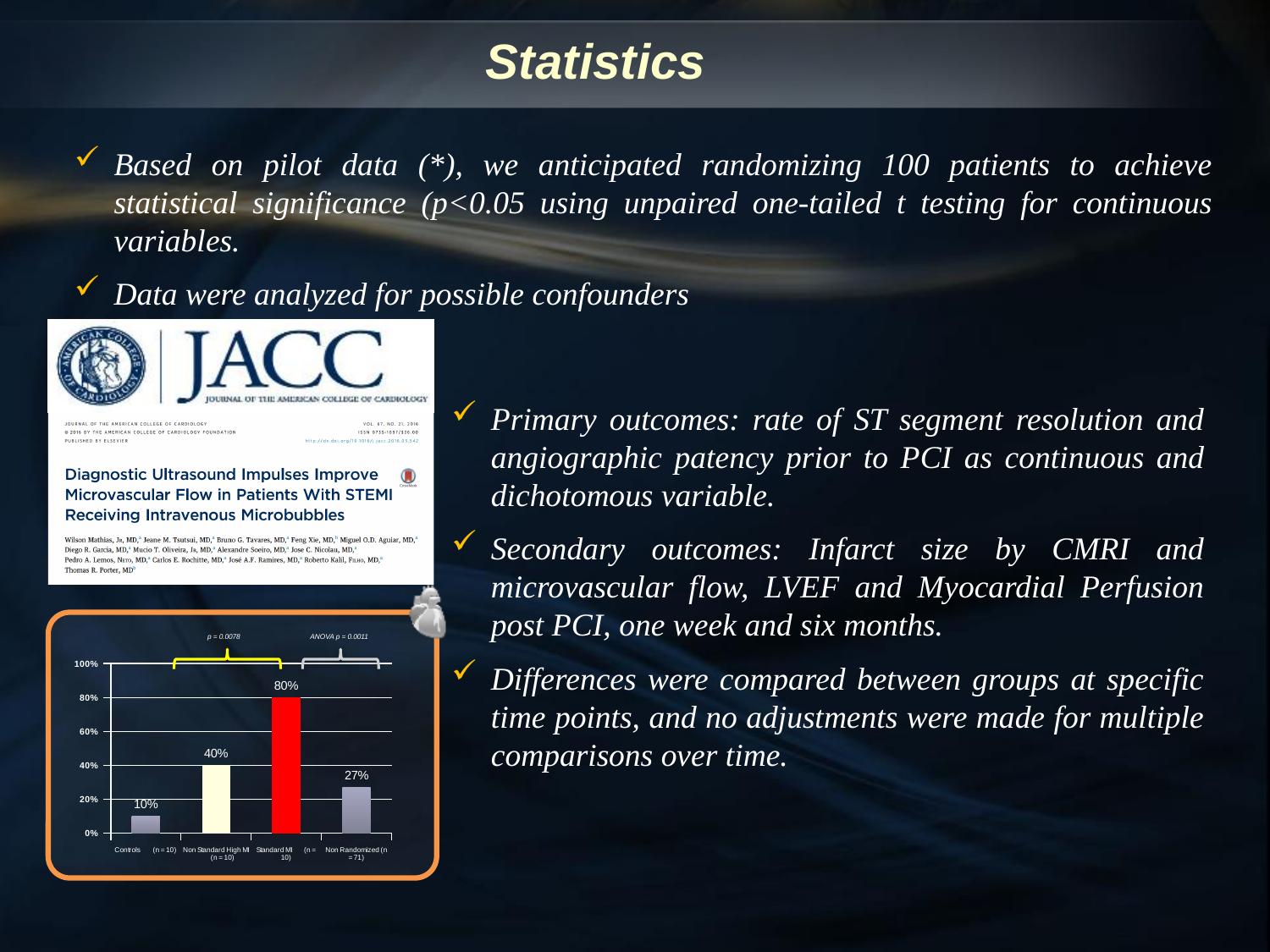
What type of chart is shown at the bottom left of the slide? Bar chart Which is larger in the bar chart, the Non Standard High MI value or the Non Randomized value? Non Standard High MI What is the highest tick value on the y axis of the bar chart? 100% What value is shown for the Non Randomized group in the bar chart? 27% What value is shown for the Controls group in the bar chart? 10% How many bars are plotted in the bar chart? 4 What value is shown for the Standard MI group in the bar chart? 80% What is the difference between the Standard MI value and the Non Standard High MI value in the bar chart? 40% What value is shown for the Non Standard High MI group in the bar chart? 40% What ANOVA p value is printed above the bar chart? ANOVA p = 0.0011 Which group has the lowest value in the bar chart? Controls Which group has the highest value in the bar chart? Standard MI